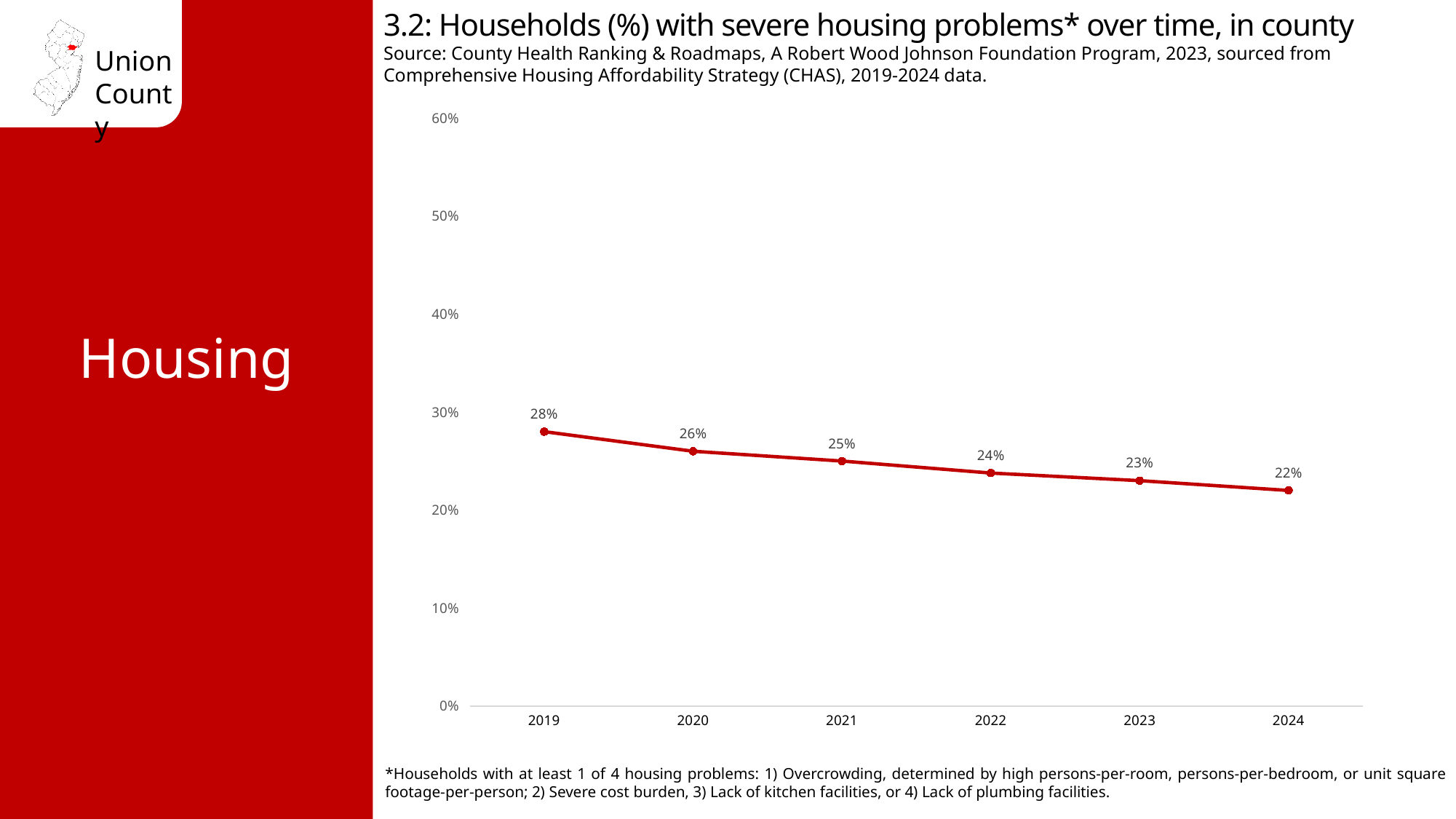
What kind of chart is shown on the slide? line chart What percentage of households had severe housing problems in 2024? 22% What is the difference between the 2019 value and the 2024 value? 6% What is the title of the chart? 3.2: Households (%) with severe housing problems* over time, in county Which year has the highest percentage of households with severe housing problems? 2019 How many years are plotted on the chart? 6 What is the value shown for 2022? 24% Is the value for 2021 greater or less than 30%? less What percentage of households had severe housing problems in 2019? 28% Which year has a higher value, 2020 or 2023? 2020 Which year has the lowest percentage of households with severe housing problems? 2024 Do the values rise or fall from 2019 to 2024? fall